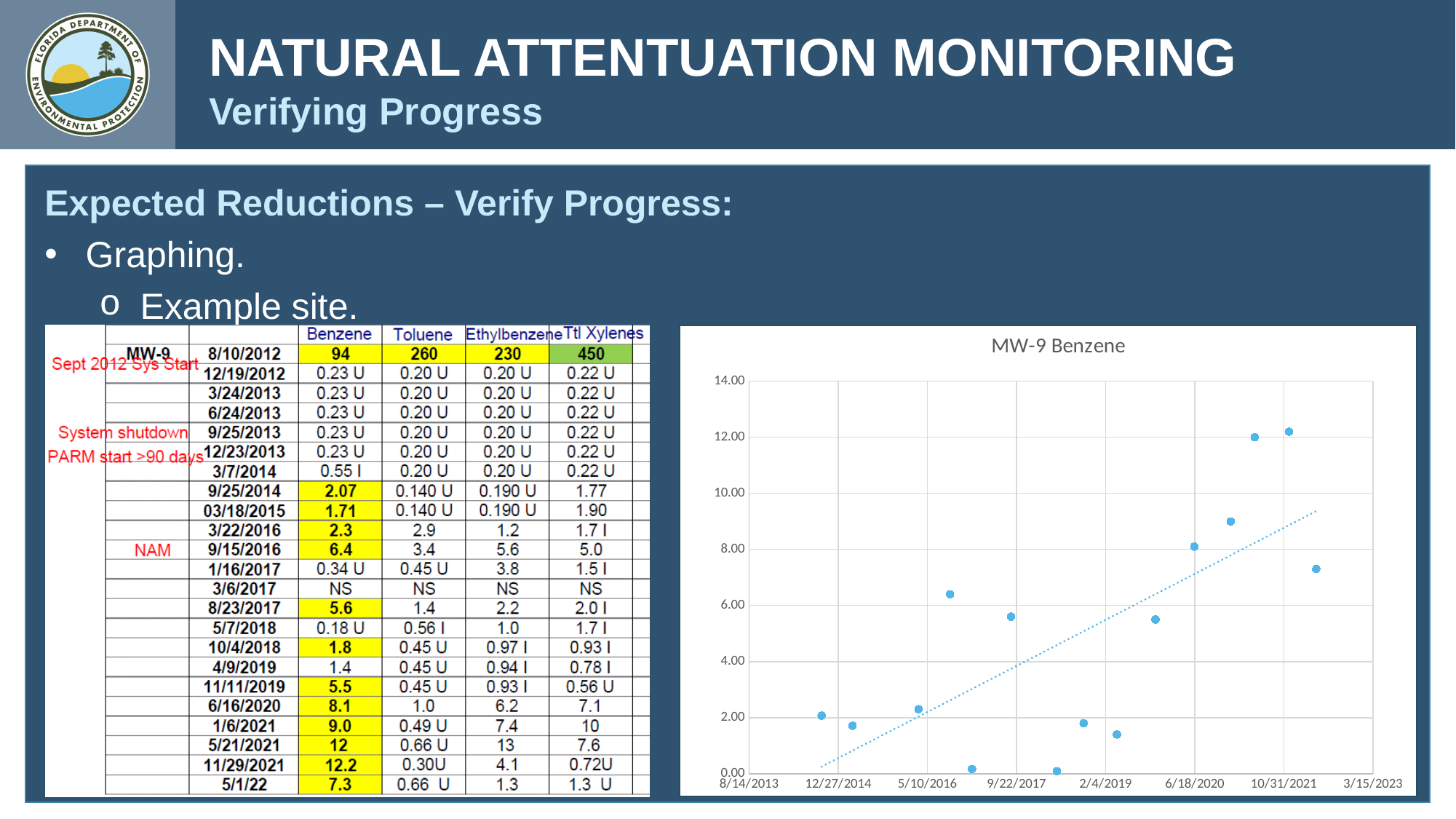
What is the title of the chart on the right side of the slide? MW-9 Benzene In the MW-9 Benzene chart, which is larger: the point near 6/18/2020 or the point near 5/10/2016? the point near 6/18/2020 In the MW-9 Benzene chart, is the value of the last (rightmost) point greater or less than 6.00? greater In the MW-9 Benzene chart, are the two points plotted near 10/31/2021 greater or less than 10.00? greater In the MW-9 Benzene chart, is the value of the first (leftmost) point greater or less than 4.00? less What is the first date label on the x axis of the MW-9 Benzene chart? 8/14/2013 How many data points are plotted in the MW-9 Benzene chart? 15 What kind of chart is the MW-9 Benzene chart? scatter chart In the MW-9 Benzene chart, does the dotted trend line rise or fall from left to right? rise What is the highest value shown on the y axis of the MW-9 Benzene chart? 14.00